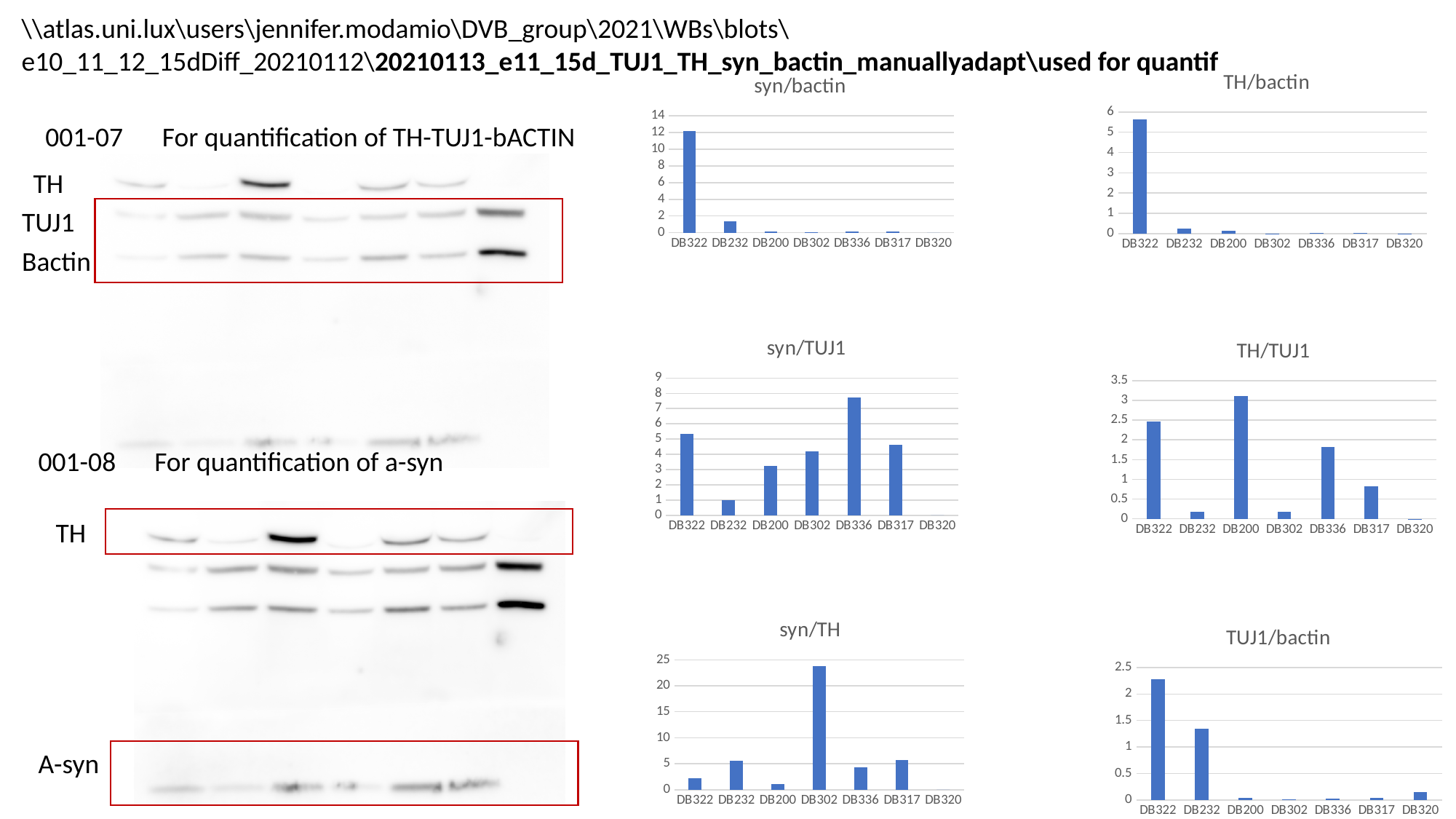
In the TH/TUJ1 chart, which category has the highest value? DB200 How many categories are shown on the x axis of the syn/TH chart? 7 In the syn/TH chart, is the value for DB302 greater or less than 20? greater In the syn/TUJ1 chart, which is larger, the value for DB322 or the value for DB232? DB322 In the syn/bactin chart, is the value for DB322 greater or less than 10? greater In the TH/TUJ1 chart, is the value for DB336 greater or less than 2? less In the TUJ1/bactin chart, which is larger, the value for DB322 or the value for DB232? DB322 In the syn/bactin chart, which category has the highest value? DB322 In the syn/TUJ1 chart, which category has the highest value? DB336 What kind of chart is the TUJ1/bactin chart? bar chart